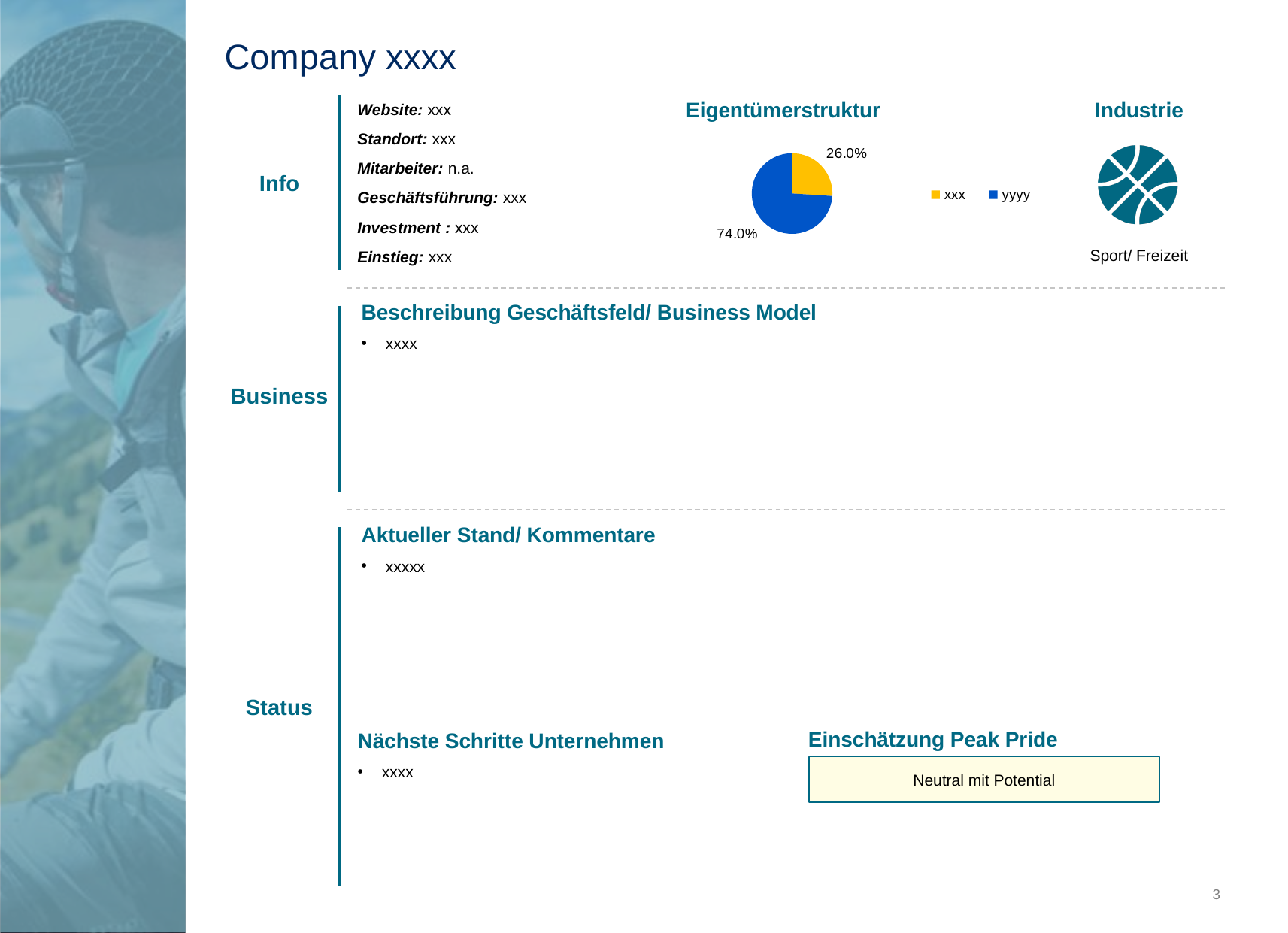
In the Eigentümerstruktur pie chart, what share is labelled for the slice xxx? 26.0% How many slices does the Eigentümerstruktur pie chart have? 2 What is the title of the pie chart on the slide? Eigentümerstruktur Which slice of the Eigentümerstruktur pie chart is the smallest? xxx In the Eigentümerstruktur pie chart, which slice is larger, xxx or yyyy? yyyy What kind of chart is shown under the heading Eigentümerstruktur? pie chart In the Eigentümerstruktur pie chart, what is the difference in percentage points between the yyyy slice and the xxx slice? 48.0 percentage points How many entries does the legend of the Eigentümerstruktur pie chart list? 2 What colour is the yyyy slice in the Eigentümerstruktur pie chart? blue In the Eigentümerstruktur pie chart, what share is labelled for the slice yyyy? 74.0% Which slice of the Eigentümerstruktur pie chart is the largest? yyyy In the Eigentümerstruktur pie chart, is the share for xxx greater or less than 50%? less